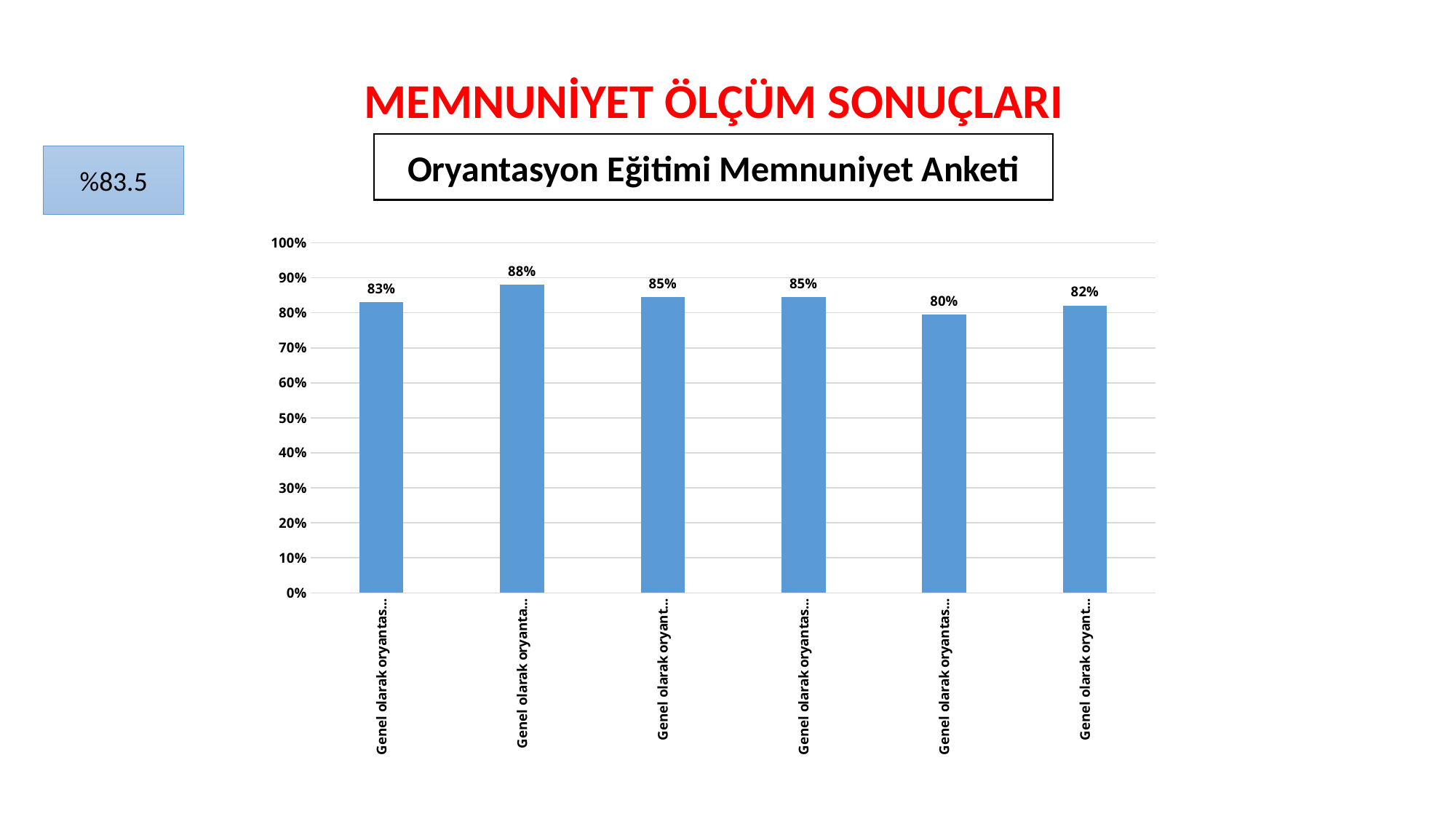
What is the title shown in the box above the chart? Oryantasyon Eğitimi Memnuniyet Anketi What type of chart is shown on the slide? bar chart Which bar has the lowest value in the chart? the fifth bar from the left (80%) What is the value of the fifth bar from the left in the chart? 80% Which bar has the highest value in the chart? the second bar from the left (88%) What is the difference between the highest and lowest bar values in the chart? 8% What is the value of the last (rightmost) bar in the chart? 82% What is the value of the first (leftmost) bar in the chart? 83% Is the value of the second bar greater or less than 90%? less How many bars are plotted in the chart? 6 Which is larger: the value of the first bar or the value of the last bar? the first bar (83%) What is the value of the second bar from the left in the chart? 88%